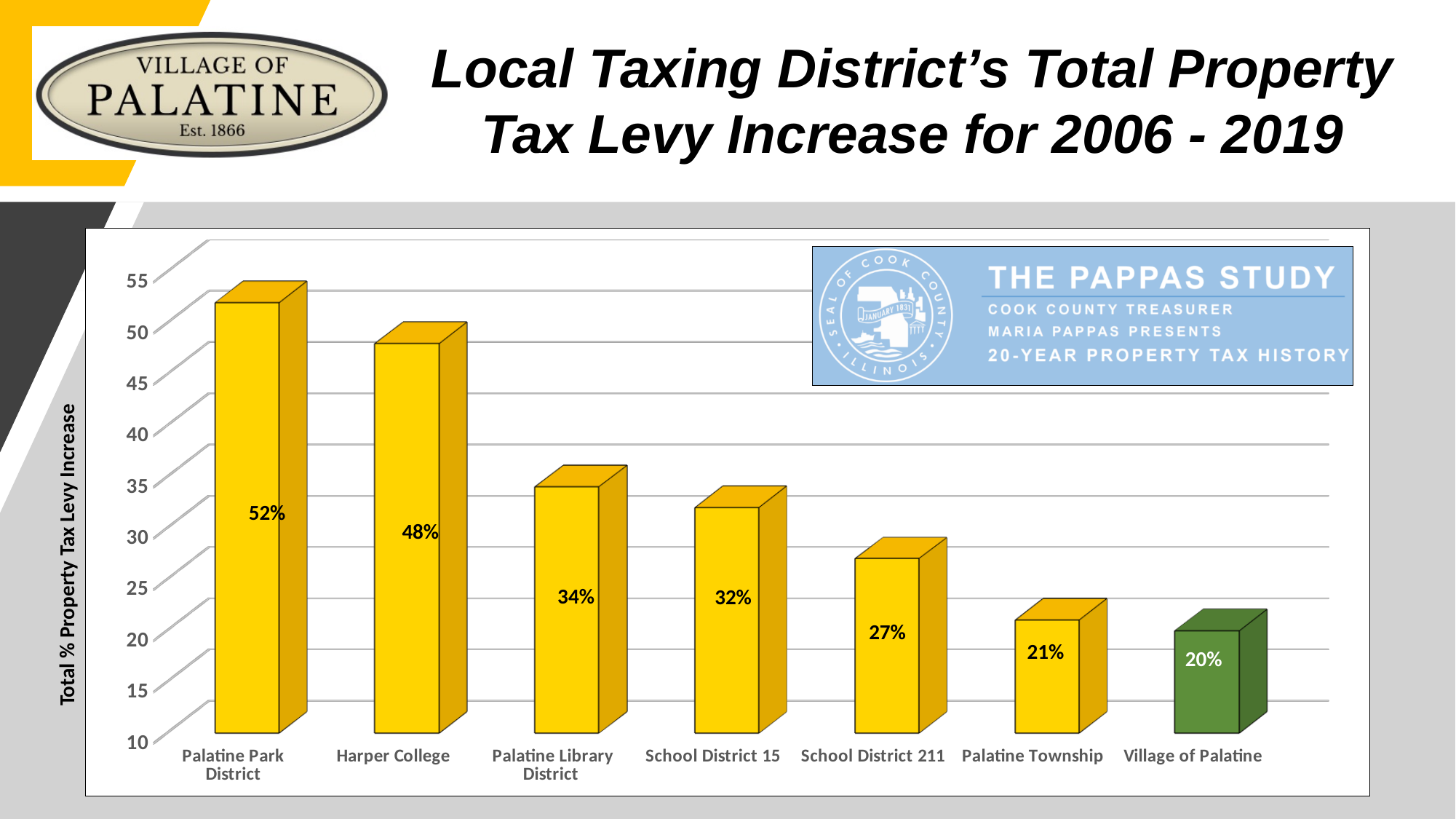
Which has a larger levy increase, School District 211 or Palatine Township? School District 211 What is the total property tax levy increase for Harper College? 48% How many taxing districts are shown in the chart? 7 What is the difference between the levy increase for Palatine Park District and the Village of Palatine? 32% Which taxing district has the lowest total property tax levy increase? Village of Palatine Which bar in the chart is coloured green rather than yellow? Village of Palatine What is the total property tax levy increase for the Village of Palatine? 20% What kind of chart is shown on the slide? Bar chart What is the total property tax levy increase for School District 211? 27% Which taxing district has the highest total property tax levy increase? Palatine Park District What is the difference between the levy increase for Palatine Library District and School District 15? 2% What is the total property tax levy increase for Palatine Park District? 52%